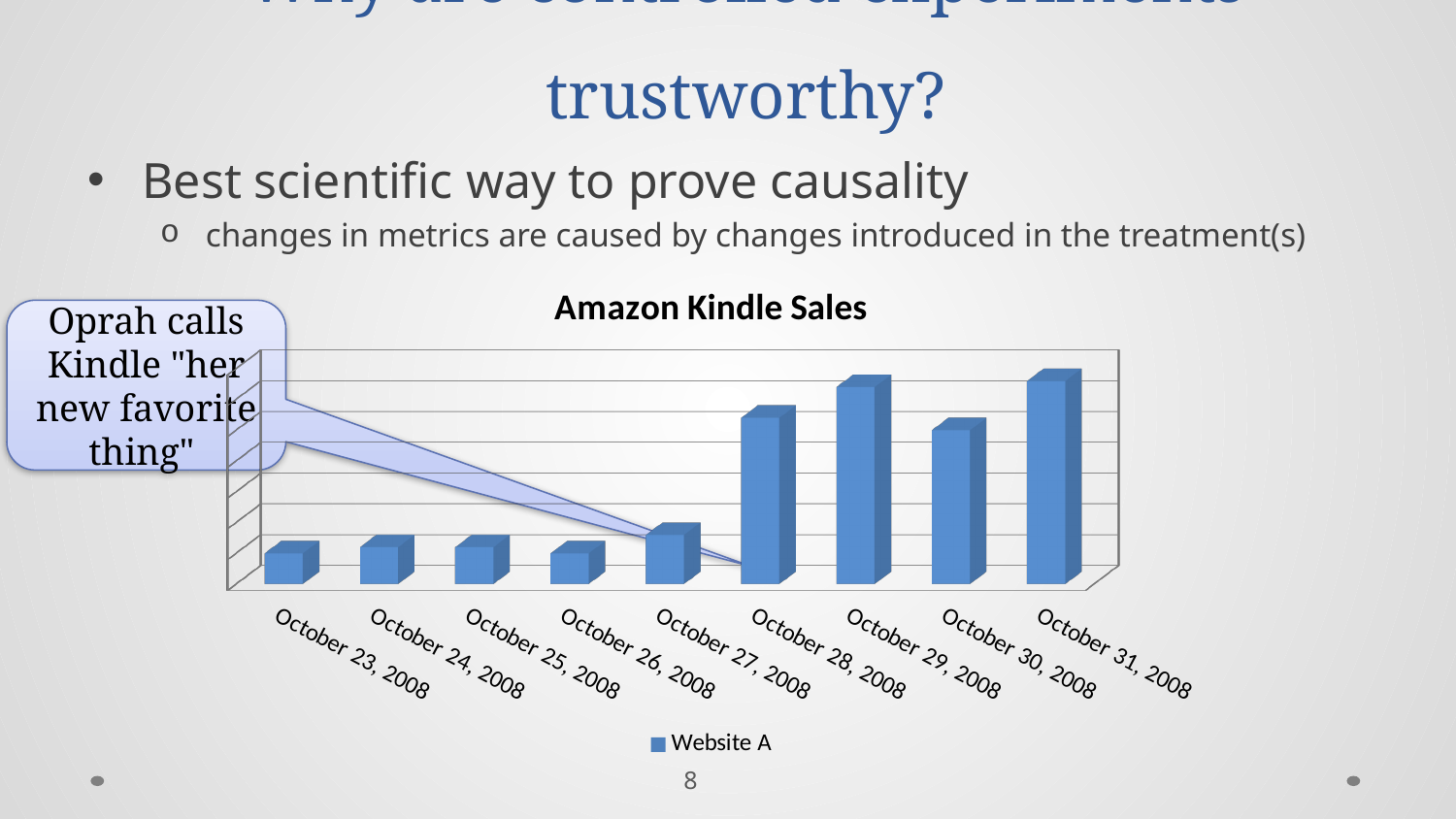
How many series does the chart's legend list? 1 Which is larger, the value for October 28, 2008 or the value for October 23, 2008? October 28, 2008 How many dates (categories) are plotted on the x axis? 9 Which is larger, the value for October 27, 2008 or the value for October 26, 2008? October 27, 2008 What type of chart is shown on the slide? bar chart What is the title of the chart? Amazon Kindle Sales Overall, do the values rise or fall from October 23, 2008 to October 31, 2008? rise Which is larger, the value for October 31, 2008 or the value for October 25, 2008? October 31, 2008 Do the values rise or fall from October 27, 2008 to October 28, 2008? rise What is the name of the series shown in the legend? Website A